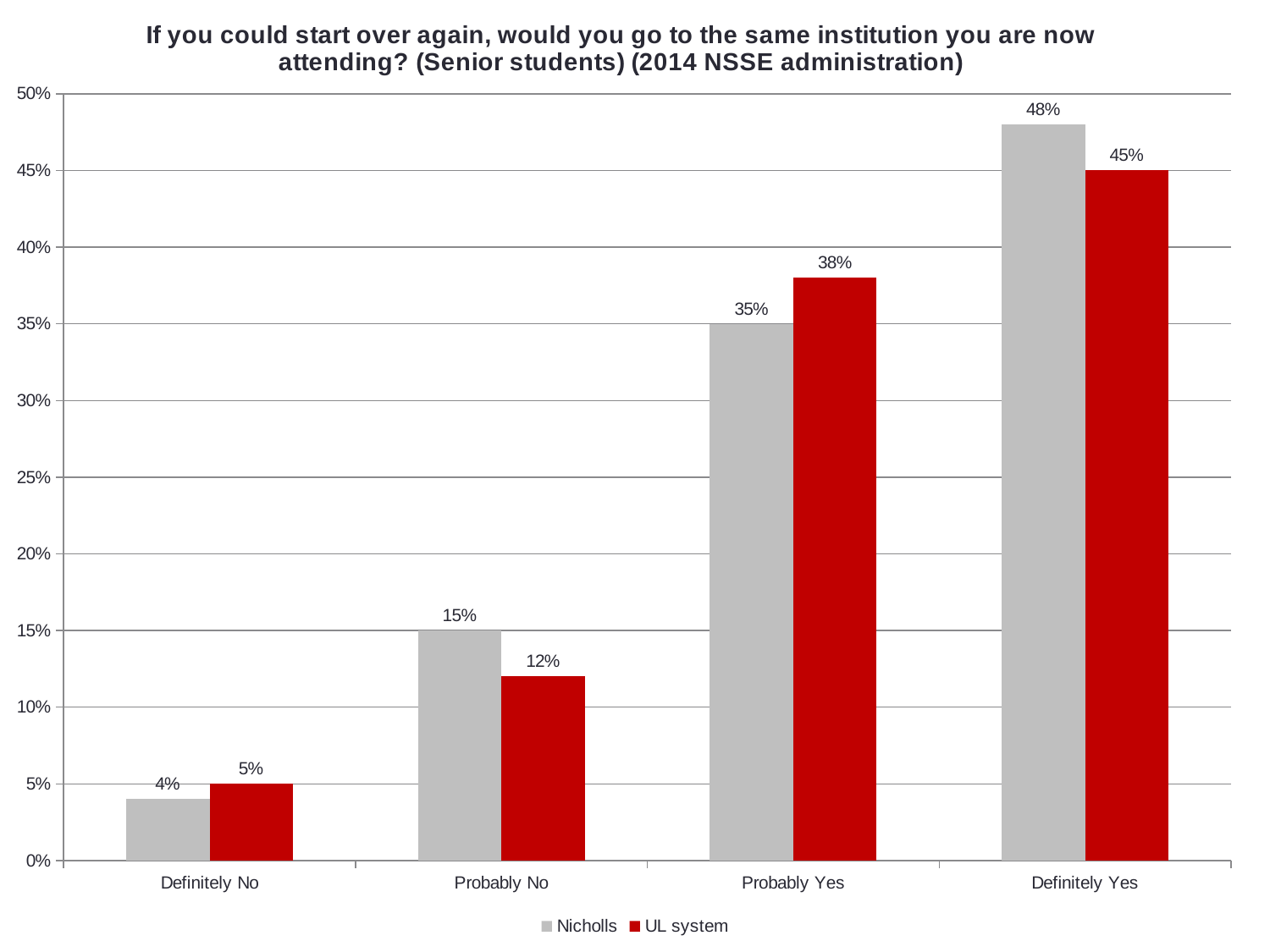
Which colour represents the UL system series? Red How many series does the legend list? 2 What is the difference between the UL system and Nicholls values for Probably Yes? 3% What is the difference between the Nicholls and UL system values for Definitely Yes? 3% What is the UL system value for Probably No? 12% Which category has the lowest UL system value? Definitely No Which is larger for Probably No, the Nicholls value or the UL system value? Nicholls How many categories are shown on the x axis? 4 Which category has the highest Nicholls value? Definitely Yes What is the Nicholls value for Probably Yes? 35% What kind of chart is shown on the slide? Bar chart What is the UL system value for Definitely Yes? 45%